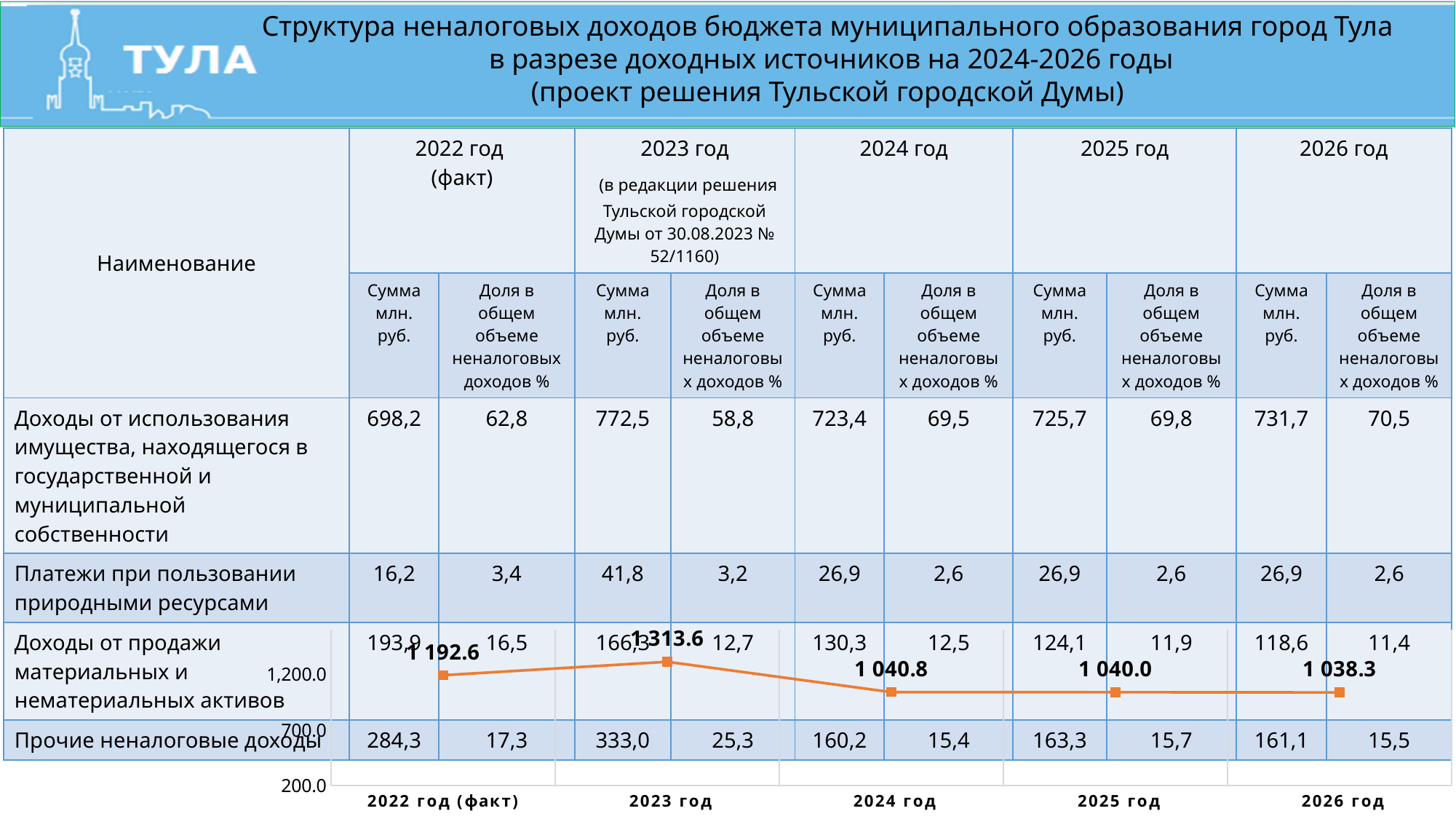
How many data points are plotted on the line chart? 5 What is the value plotted for 2023 год on the line chart? 1 313.6 Which is larger on the line chart, the value for 2022 год (факт) or the value for 2024 год? 2022 год (факт) What is the value plotted for 2022 год (факт) on the line chart? 1 192.6 What type of chart is shown on the slide? line chart Which year has the highest value on the line chart? 2023 год Does the line chart rise or fall from 2023 год to 2026 год? fall What is the difference between the 2023 год and 2022 год (факт) values on the line chart? 121.0 What is the value plotted for 2026 год on the line chart? 1 038.3 What is the value plotted for 2025 год on the line chart? 1 040.0 What is the value plotted for 2024 год on the line chart? 1 040.8 Which year has the lowest value on the line chart? 2026 год